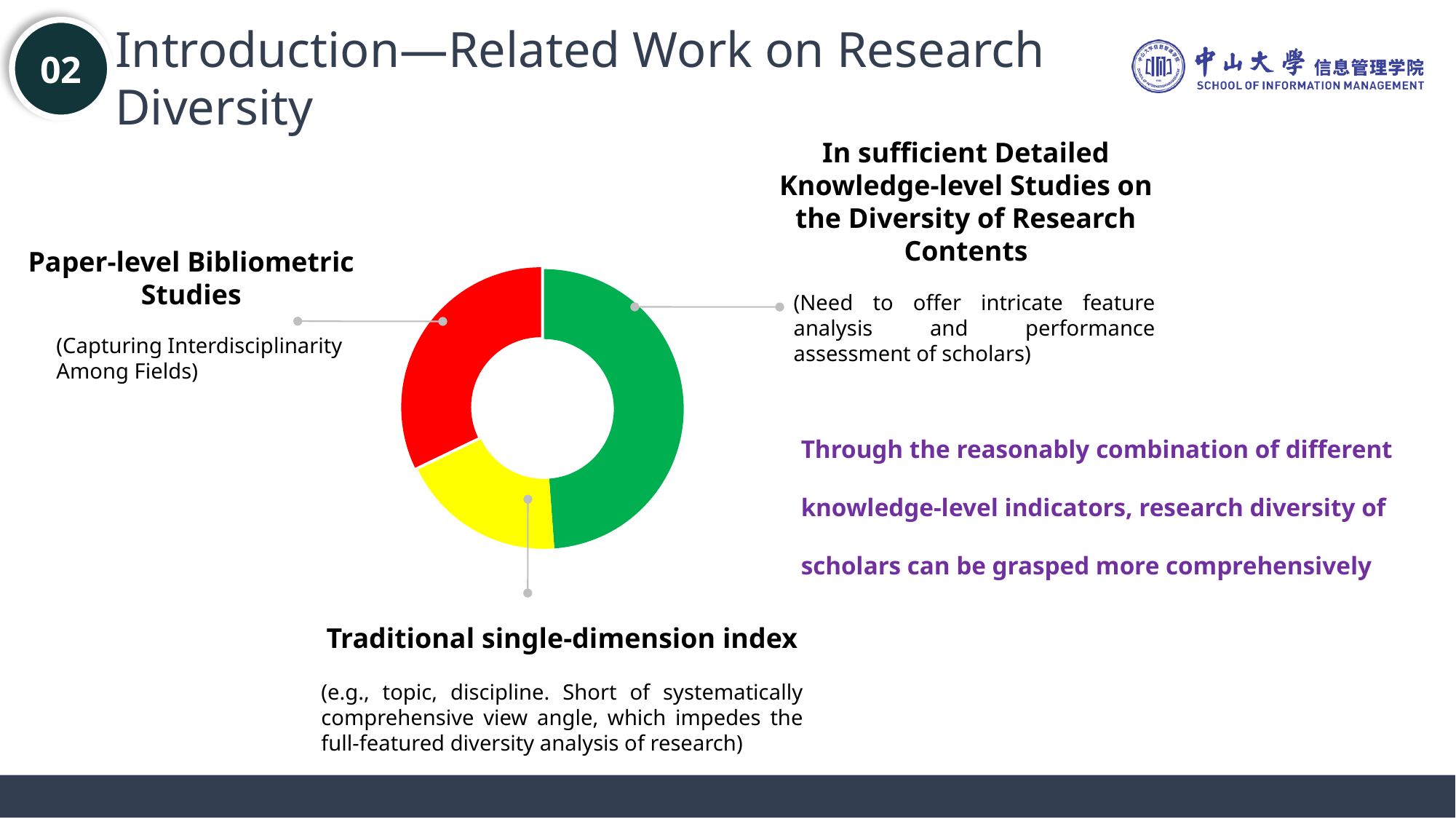
Which segment is larger: Paper-level Bibliometric Studies or Traditional single-dimension index? Paper-level Bibliometric Studies What colour is the segment labelled Paper-level Bibliometric Studies? Red Which segment of the donut chart is the largest? In sufficient Detailed Knowledge-level Studies on the Diversity of Research Contents What kind of chart is shown on the slide? Donut chart Which segment of the donut chart is the smallest? Traditional single-dimension index Which segment is larger: Paper-level Bibliometric Studies or In sufficient Detailed Knowledge-level Studies on the Diversity of Research Contents? In sufficient Detailed Knowledge-level Studies on the Diversity of Research Contents What colour is the segment labelled Traditional single-dimension index? Yellow How many segments does the donut chart have? 3